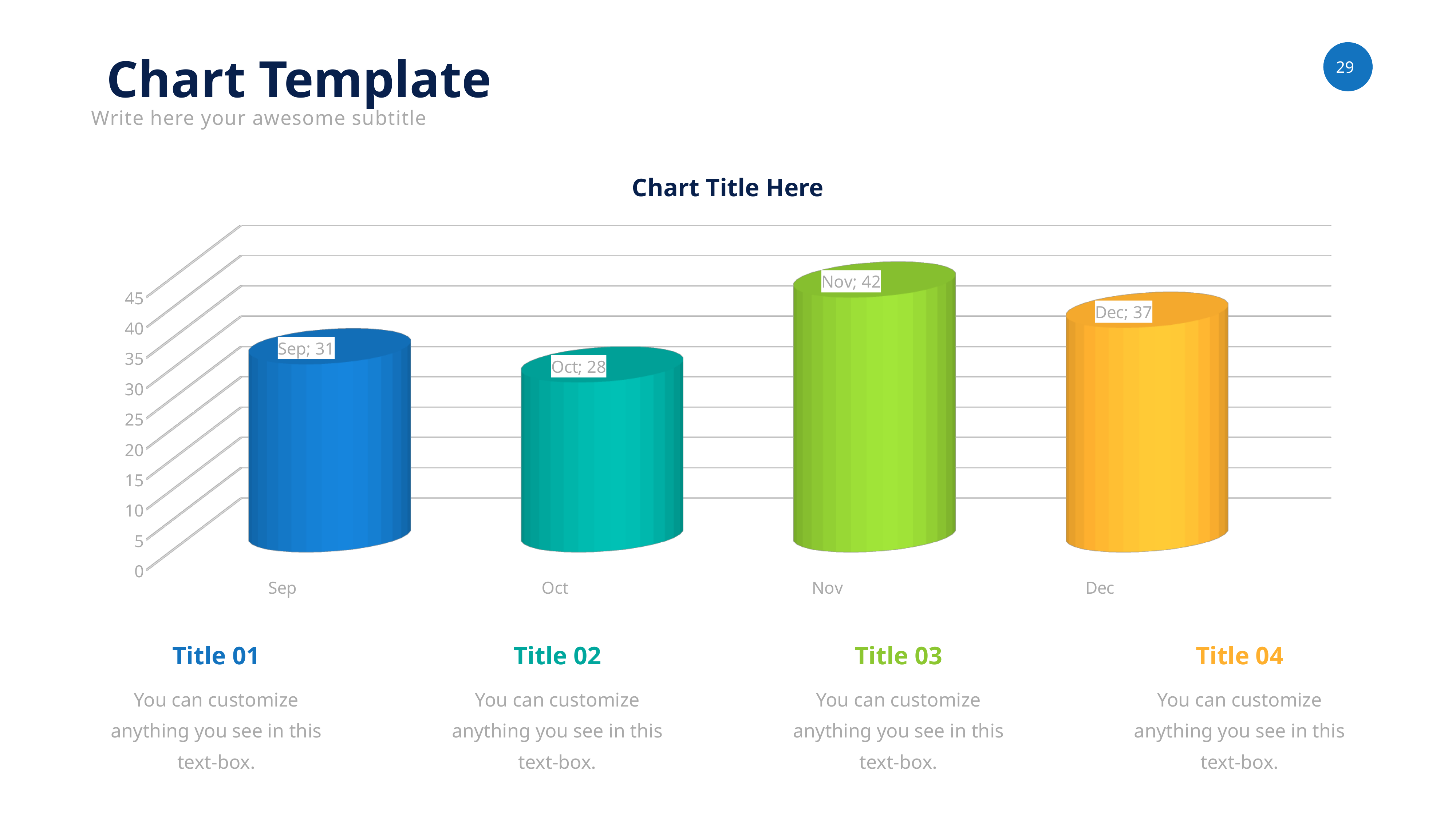
What is the value for Sep? 31 Which month has the lowest value? Oct Which is larger, the value for Sep or the value for Dec? Dec What is the title of the chart? Chart Title Here How many categories are shown on the x axis? 4 What is the difference between the values for Nov and Oct? 14 What is the difference between the values for Dec and Sep? 6 What is the value for Nov? 42 Which month has the highest value? Nov What kind of chart is shown on the slide? Bar chart What is the value for Oct? 28 What is the value for Dec? 37